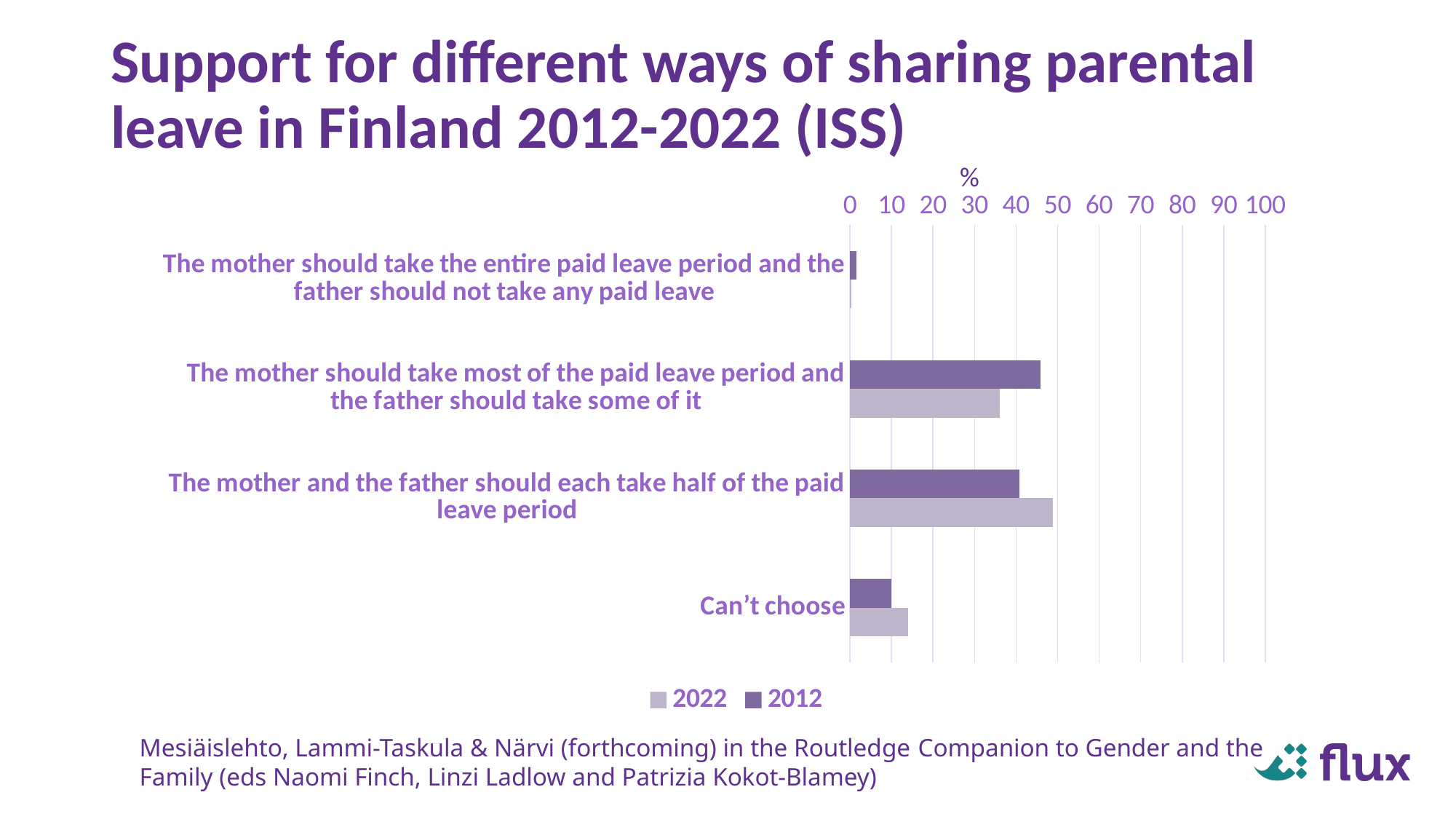
How many categories are shown on the chart? 4 How many series does the legend list? 2 For 'Can't choose', which year has the larger value, 2012 or 2022? 2022 What kind of chart is shown on the slide? bar chart Is the 2022 value for 'The mother should take most of the paid leave period and the father should take some of it' greater or less than 40? less For 'The mother and the father should each take half of the paid leave period', which year has the larger value, 2012 or 2022? 2022 Which category has the highest value for 2012? The mother should take most of the paid leave period and the father should take some of it Which series does the legend list first? 2022 Is the 2012 value for 'The mother should take most of the paid leave period and the father should take some of it' greater or less than 40? greater What is the title of the chart? Support for different ways of sharing parental leave in Finland 2012-2022 (ISS) Which category has the lowest value for 2012? The mother should take the entire paid leave period and the father should not take any paid leave Which category has the highest value for 2022? The mother and the father should each take half of the paid leave period